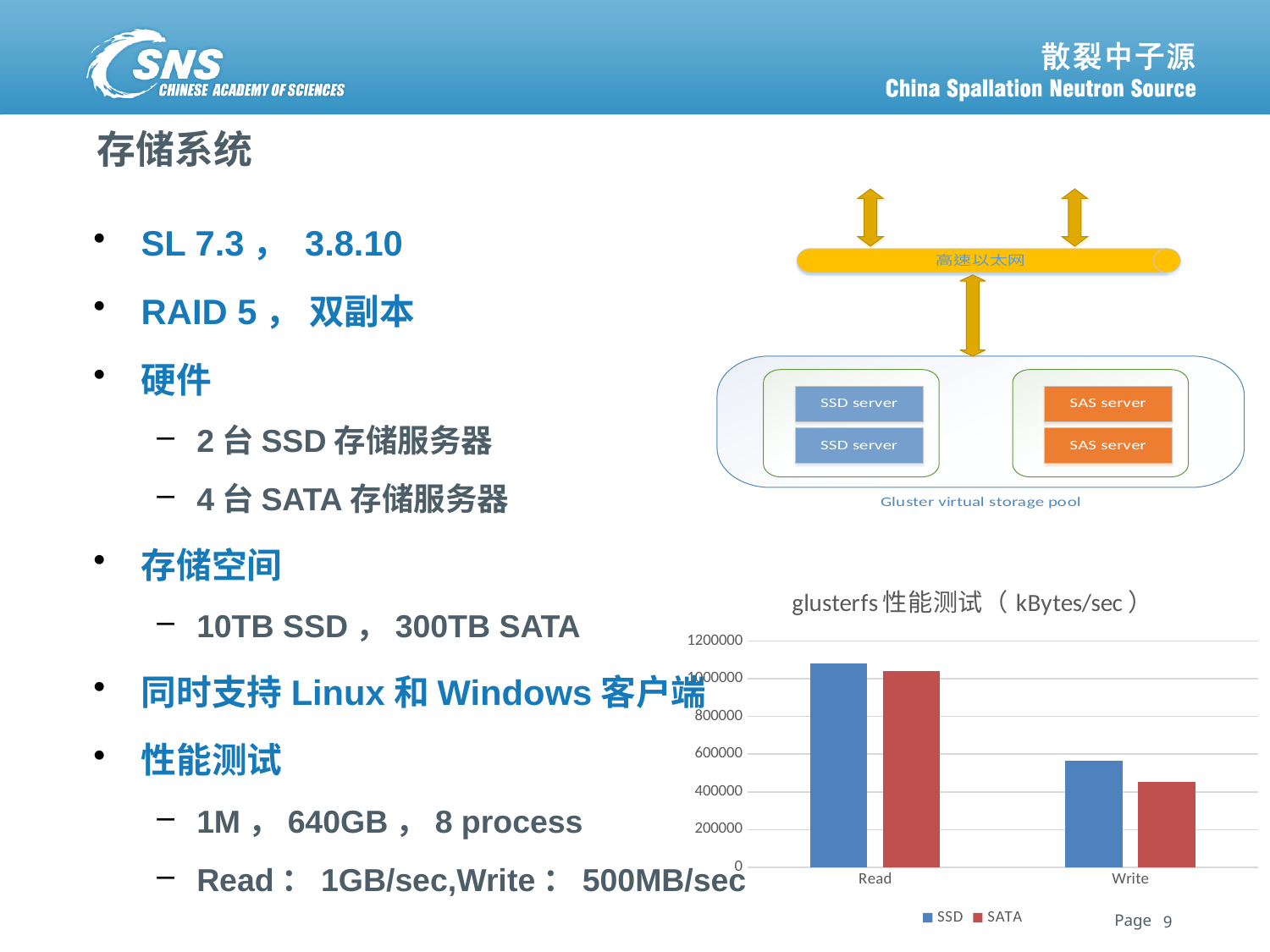
What unit is given in the title of the glusterfs 性能测试 chart? kBytes/sec What kind of chart is the glusterfs 性能测试 chart? bar chart How many categories are shown on the x axis of the glusterfs 性能测试 chart? 2 For Write, which series has the larger value, SSD or SATA? SSD Which bar is the lowest in the glusterfs 性能测试 chart? SATA for Write Is the SSD value for Read greater or less than 1000000? greater How many series does the legend of the glusterfs 性能测试 chart list? 2 Is the SSD value for Write greater or less than 400000? greater Is the SSD value for Read greater or less than 1200000? less Which series are listed in the legend of the glusterfs 性能测试 chart? SSD and SATA Do the SSD values rise or fall from Read to Write? fall